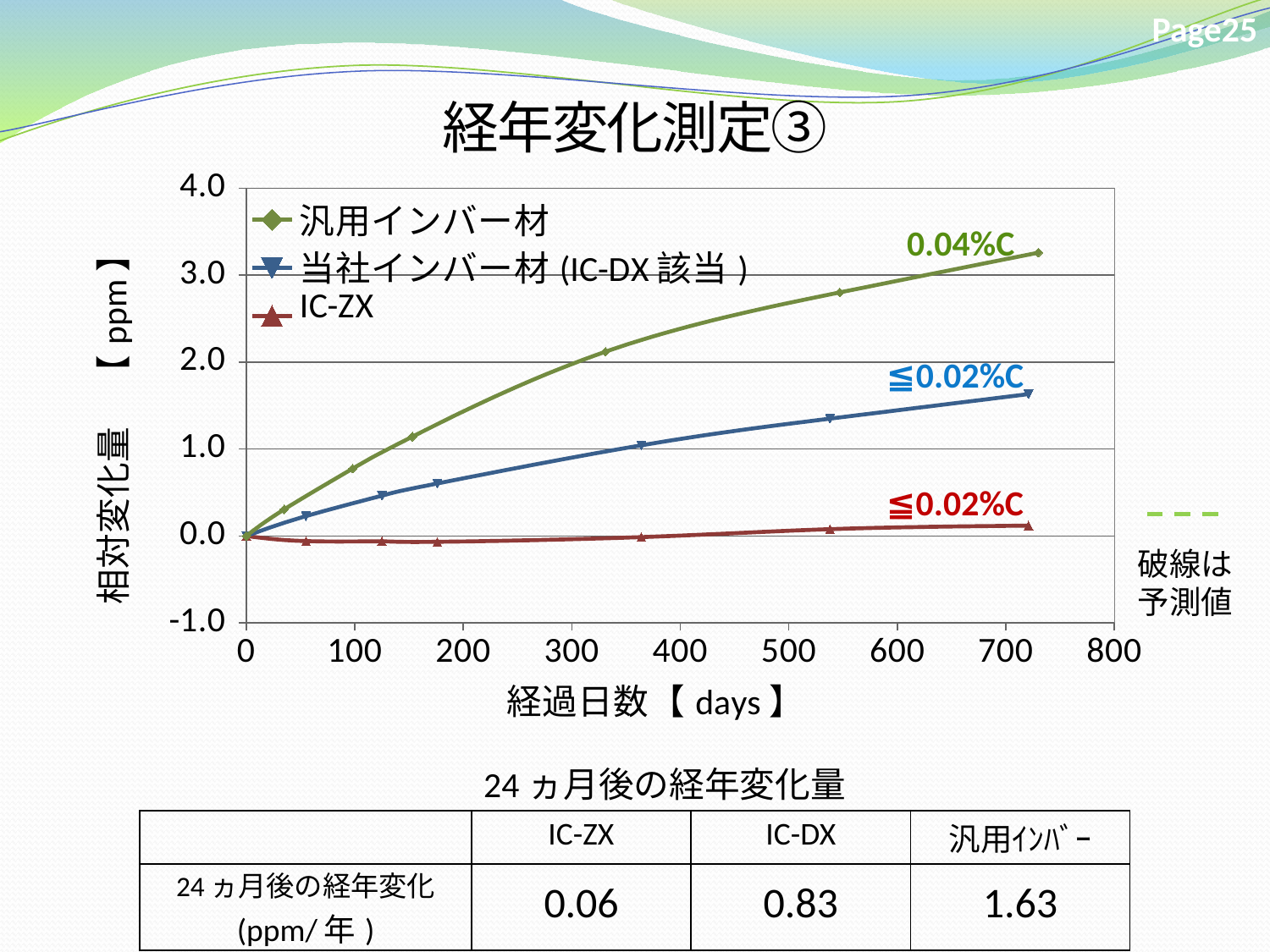
Does the value for 汎用インバー材 rise or fall as the number of days increases? rise What kind of chart is shown on the slide? line chart What is the label of the x axis? 経過日数 【 days 】 What annotation is printed next to the 汎用インバー材 line? 0.04%C Is the value for IC-ZX at around 700 days greater or less than 1.0? less What is the maximum value shown on the y axis? 4.0 Which series has the lowest value at around 700 days? IC-ZX Which series has the highest value at around 700 days? 汎用インバー材 Is the value for 当社インバー材 (IC-DX 該当) at around 700 days greater or less than 2.0? less Is the value for 汎用インバー材 at around 700 days greater or less than 3.0? greater At around 500 days, which is larger: the value for 汎用インバー材 or the value for 当社インバー材 (IC-DX 該当)? 汎用インバー材 How many series does the chart legend list? 3